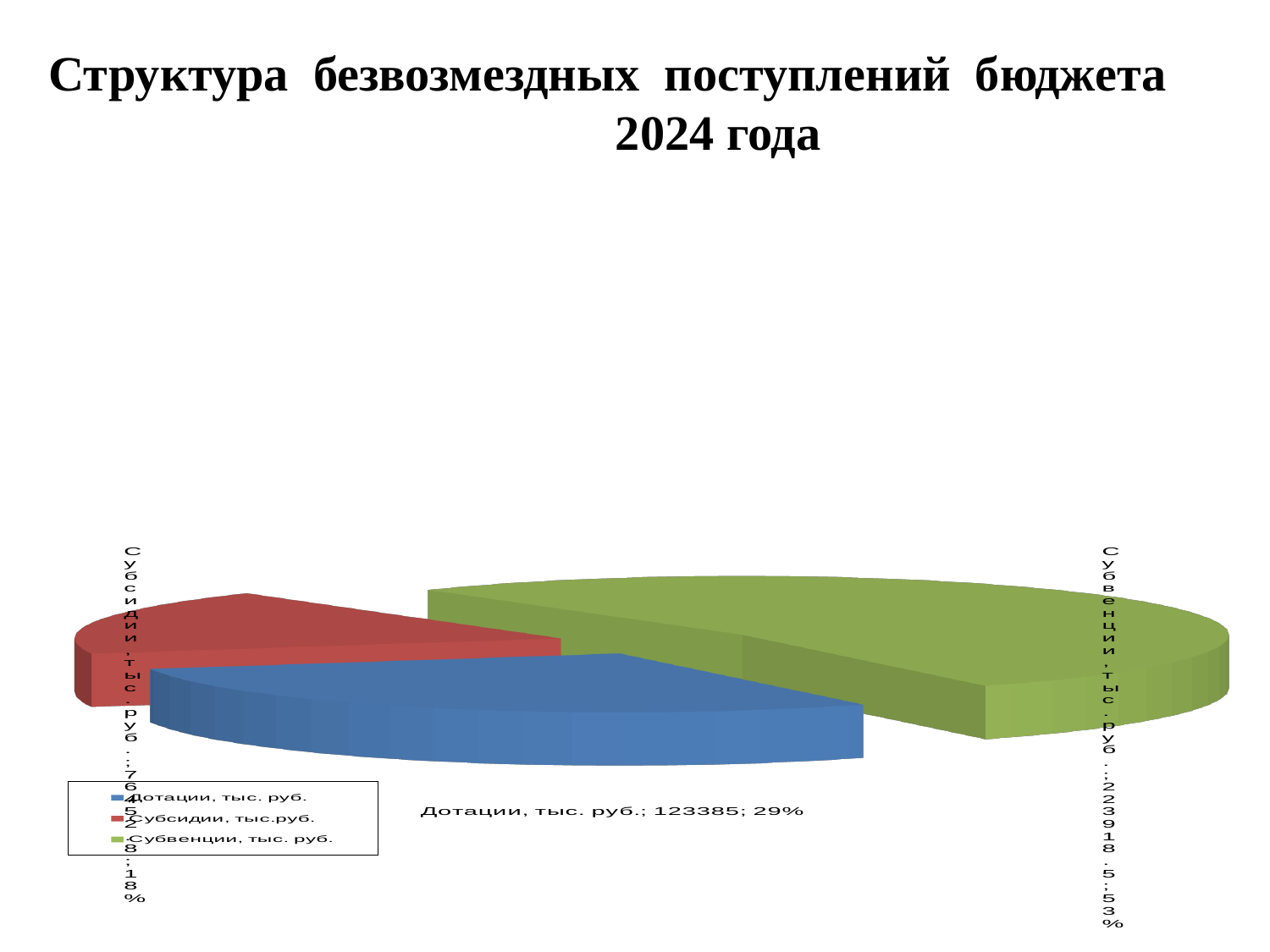
How many slices does the pie chart have? 3 What is the title of the slide containing the chart? Структура безвозмездных поступлений бюджета 2024 года What is the value shown for Субвенции, тыс. руб.? 223918,5 What is the value shown for Субсидии, тыс. руб.? 76452,8 Which is larger, the value for Дотации or the value for Субсидии? Дотации Which category has the smallest slice of the pie? Субсидии, тыс. руб. What share of the pie does Субвенции, тыс. руб. represent? 53% What is the value shown for Дотации, тыс. руб.? 123385 How many entries does the legend list? 3 Which category has the largest slice of the pie? Субвенции, тыс. руб. What share of the pie does Дотации, тыс. руб. represent? 29% What kind of chart is shown on the slide? pie chart